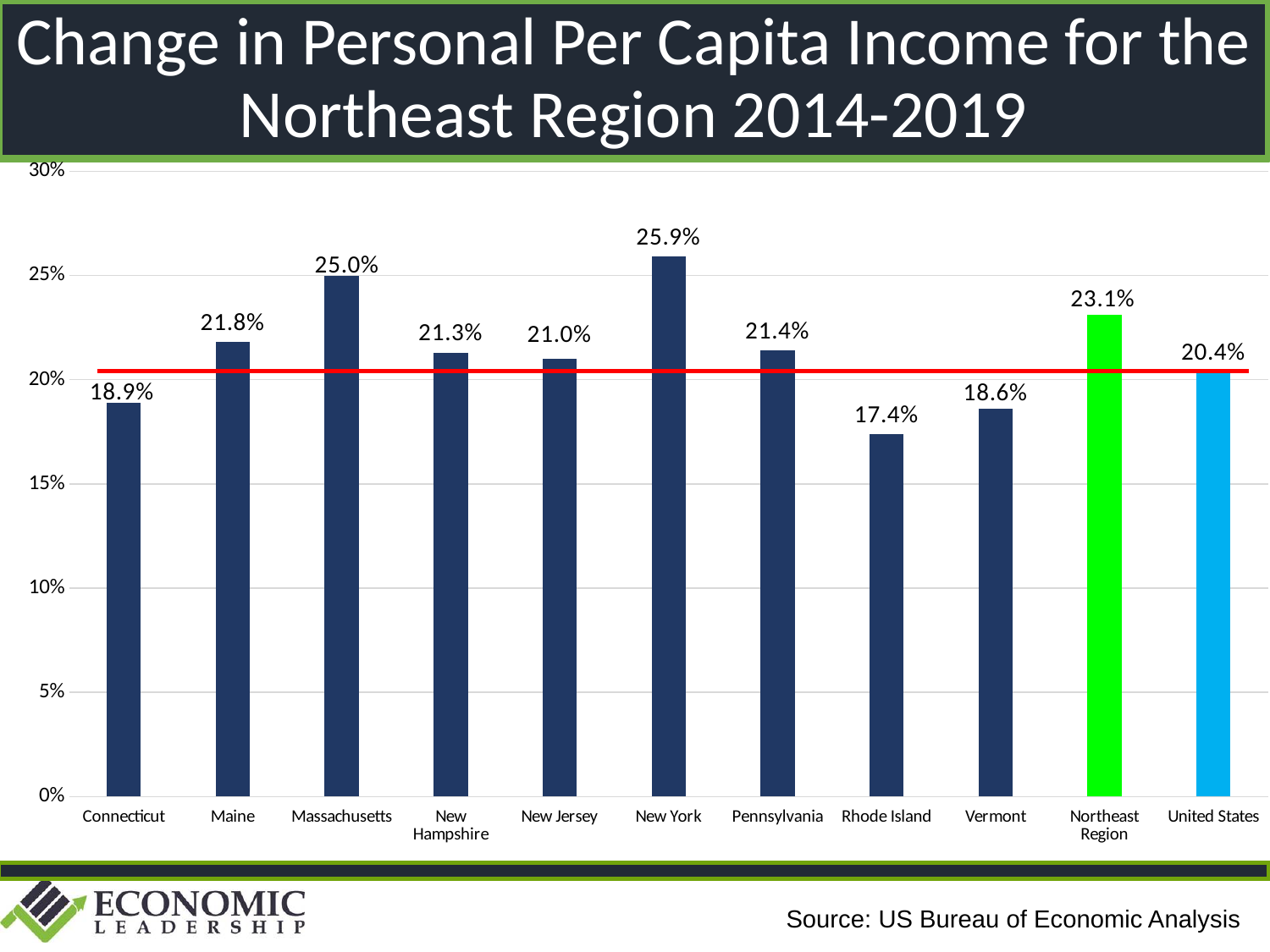
How many categories are shown on the x axis? 11 What is the difference between the Northeast Region value and the United States value? 2.7% Which is larger, the value for Vermont or the value for Connecticut? Connecticut What is the difference between the values for Massachusetts and Maine? 3.2% Which category has the highest change in personal per capita income? New York Which category has the lowest change in personal per capita income? Rhode Island What is the title of the chart? Change in Personal Per Capita Income for the Northeast Region 2014-2019 What is the value shown for the Northeast Region? 23.1% What kind of chart is shown on the slide? Bar chart What is the change in personal per capita income for New York? 25.9% Is the value for Pennsylvania greater or less than 20%? greater What is the value shown for Rhode Island? 17.4%